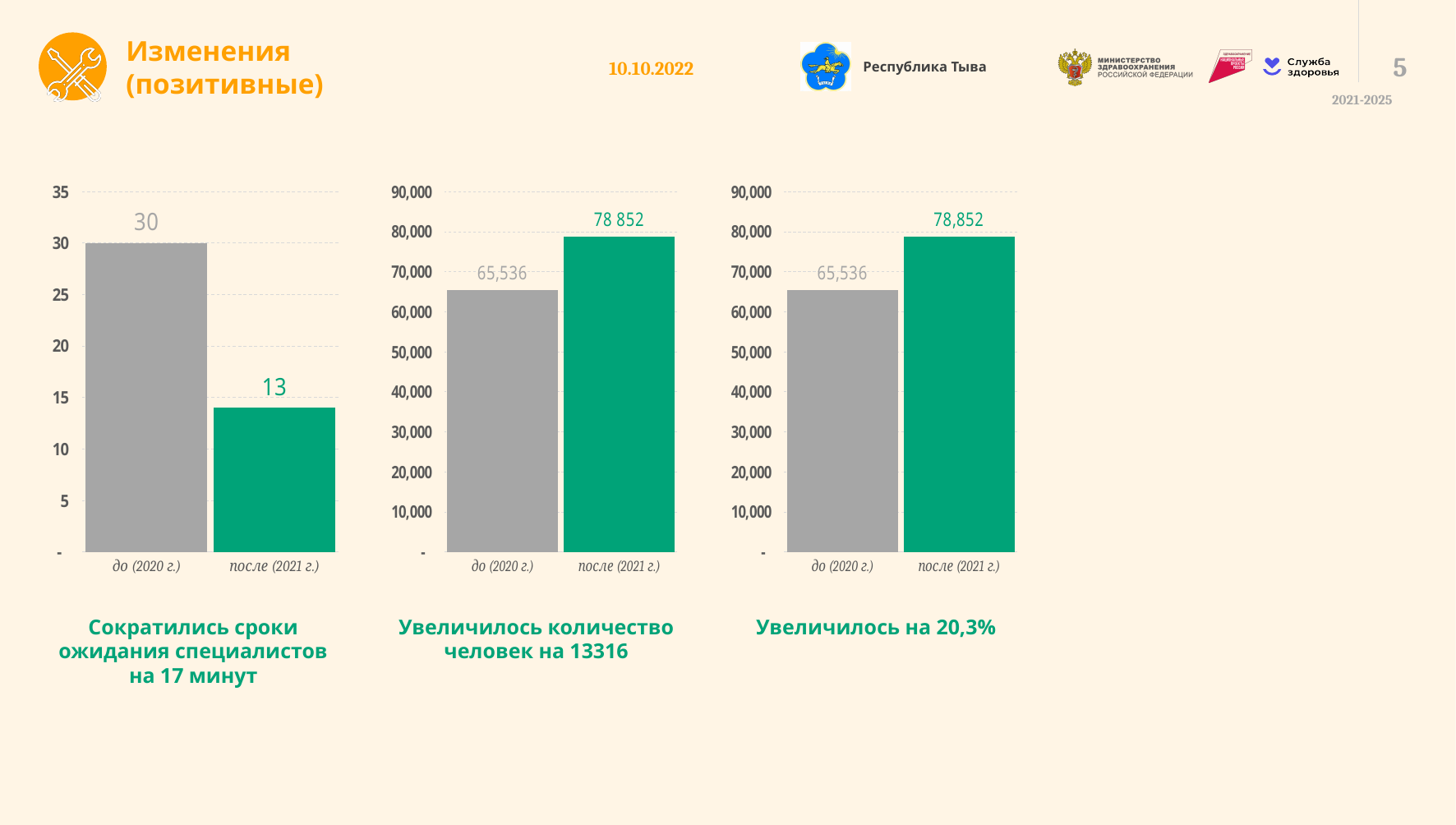
In the middle chart, what is the value for после (2021 г.)? 78 852 In the left chart, what is the value for после (2021 г.)? 13 In the middle chart, which category has the higher value? после (2021 г.) What type of chart is the middle chart? bar chart In the left chart, which category has the lower value? после (2021 г.) How many categories does the left chart show? 2 In the middle chart, what is the value for до (2020 г.)? 65,536 In the right chart, what is the value for после (2021 г.)? 78,852 In the left chart, what is the difference between the до (2020 г.) and после (2021 г.) values? 17 In the right chart, is the value for до (2020 г.) greater or less than 70,000? less In the right chart, what is the difference between the после (2021 г.) and до (2020 г.) values? 13,316 In the left chart, what is the value for до (2020 г.)? 30